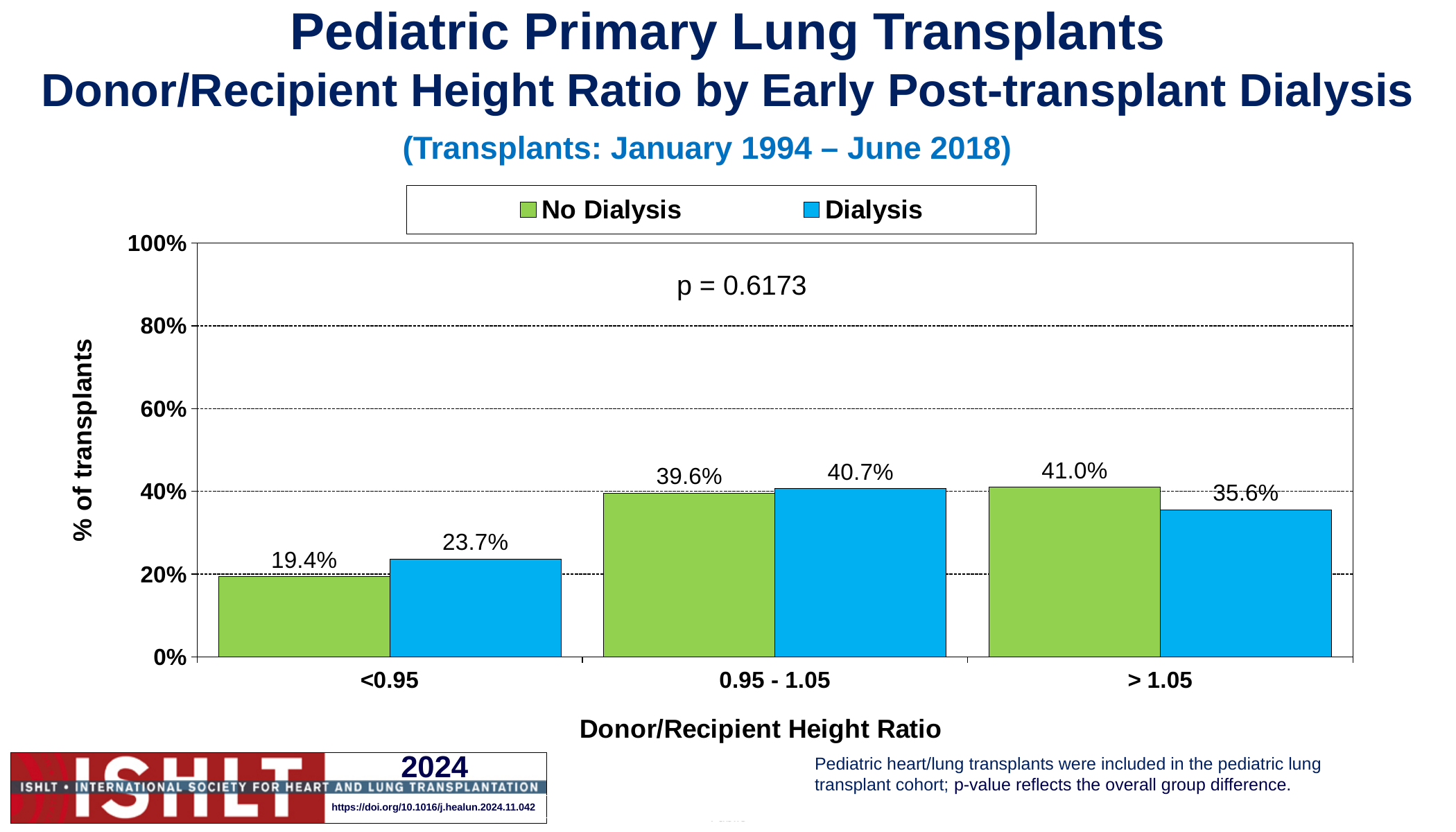
What is the value for Dialysis in the 0.95 - 1.05 height ratio category? 40.7% What is the difference between the Dialysis and No Dialysis values in the <0.95 category? 4.3% What kind of chart is shown on the slide? Bar chart How many series does the legend list? 2 In the > 1.05 category, which series has the larger value, No Dialysis or Dialysis? No Dialysis Which height ratio category has the lowest value for Dialysis? <0.95 Is the value for No Dialysis in the 0.95 - 1.05 category greater or less than 40%? less What p-value is printed on the chart? p = 0.6173 What is the value for Dialysis in the > 1.05 height ratio category? 35.6% How many height ratio categories are shown on the x axis? 3 What is the value for No Dialysis in the <0.95 height ratio category? 19.4% Which height ratio category has the highest value for No Dialysis? > 1.05